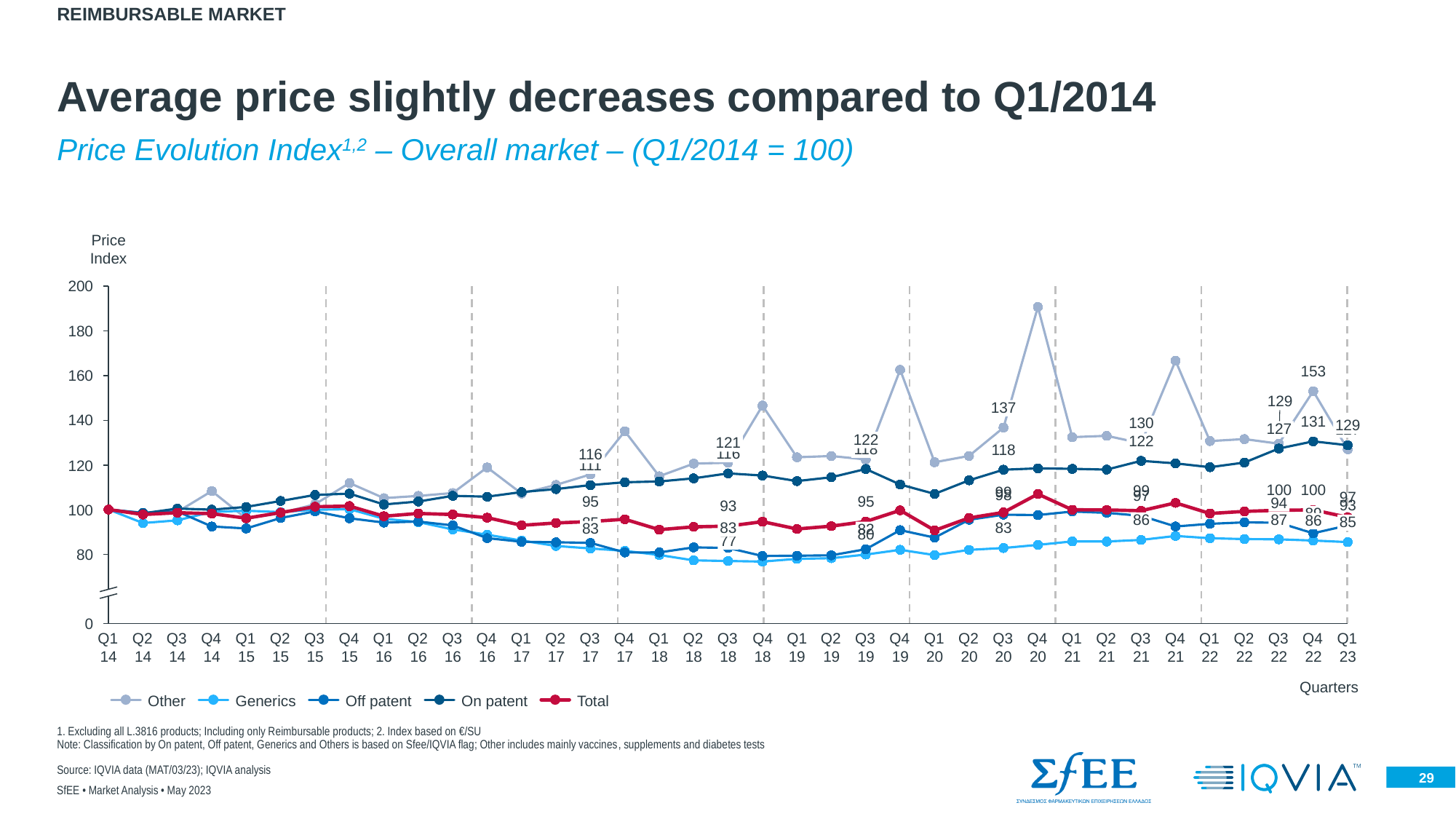
What is the value of the Other series in Q4 22? 153 Which is larger: the Other value in Q3 20 or the Other value in Q3 21? Q3 20 Which series has the highest value in Q4 22? Other Which series has the lowest value in Q3 22? Generics What is the value of the On patent series in Q4 22? 131 What is the value of the Generics series in Q3 22? 87 How many quarters are plotted along the x axis? 37 What type of chart is shown on the slide? Line chart How many series does the legend list? 5 What is the value of the Total series in Q3 18? 93 What is the difference between the Other value (153) and the On patent value (131) in Q4 22? 22 Is the value of the Other series in Q4 20 greater or less than 180? greater